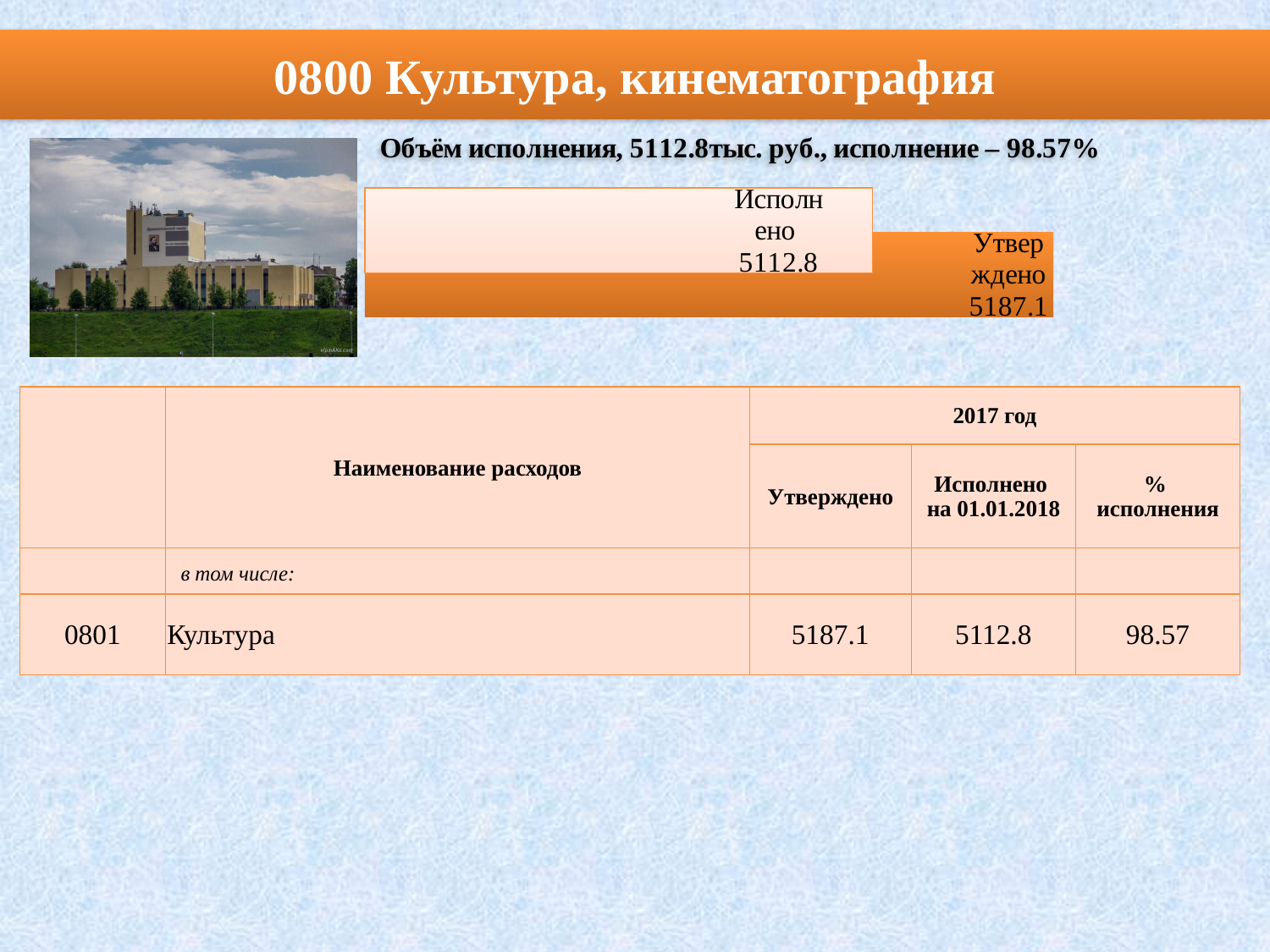
Which bar in the chart is drawn in dark orange? Утверждено What is the value of the bar labelled Утверждено? 5187.1 Which bar in the chart has the lowest value? Исполнено What is the value of the bar labelled Исполнено? 5112.8 Are the bars in the chart horizontal or vertical? horizontal What is the difference between the Утверждено and Исполнено values in the chart? 74.3 Which bar has the higher value, Исполнено or Утверждено? Утверждено How many bars are plotted in the chart? 2 Which bar in the chart has the highest value? Утверждено What kind of chart is shown on the slide? bar chart